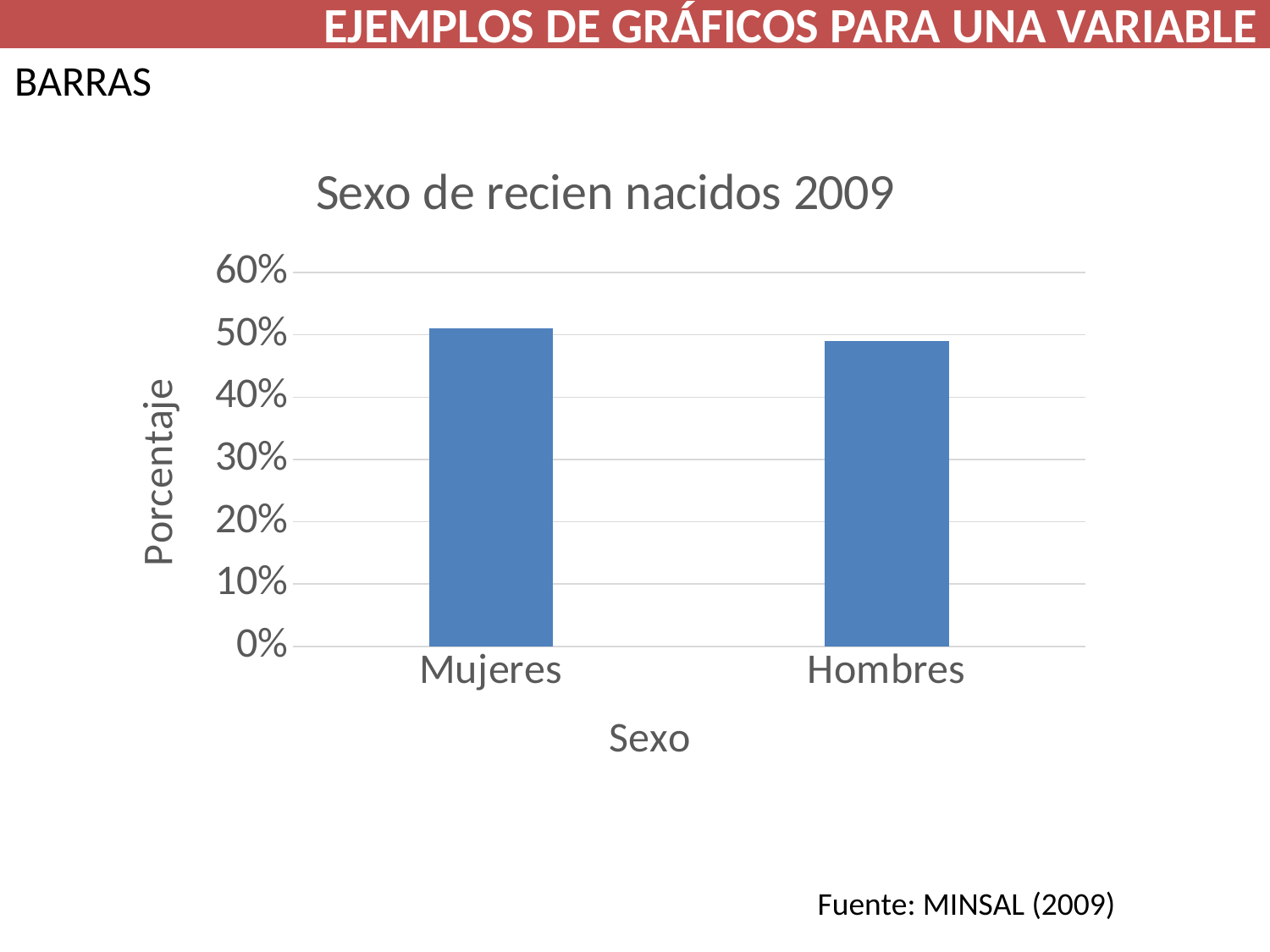
What is the title of the chart? Sexo de recien nacidos 2009 What is the label of the vertical axis of the chart? Porcentaje Is the value for Hombres greater or less than 40%? greater Which category has the lowest bar in the chart? Hombres Do the values rise or fall from Mujeres to Hombres along the x axis? fall How many categories are shown on the x axis of the chart? 2 Is the value for Mujeres greater or less than 60%? less Which category has the highest bar in the chart? Mujeres What kind of chart is shown on the slide? bar chart Which is larger, the value for Mujeres or the value for Hombres? Mujeres